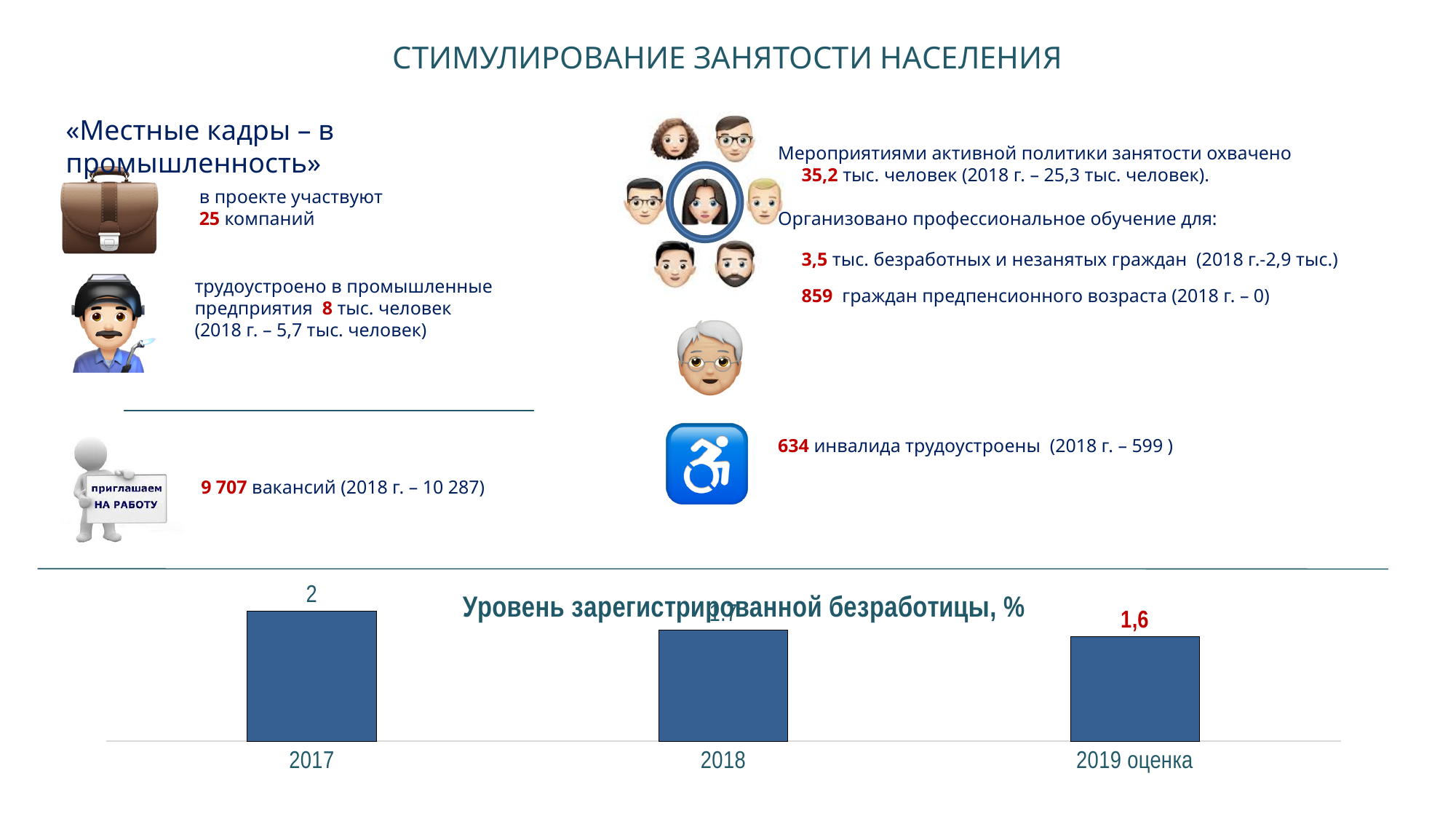
In the chart 'Уровень зарегистрированной безработицы, %', do the values rise or fall from 2017 to 2019 оценка? fall How many bars are plotted in the chart 'Уровень зарегистрированной безработицы, %'? 3 In the chart 'Уровень зарегистрированной безработицы, %', what is the difference between the 2017 value and the 2019 оценка value? 0,4 In the chart 'Уровень зарегистрированной безработицы, %', is the value for 2018 greater or less than 2? less What is the title of the chart at the bottom of the slide? Уровень зарегистрированной безработицы, % In the chart 'Уровень зарегистрированной безработицы, %', which is larger: the value for 2017 or for 2019 оценка? 2017 What type of chart is shown at the bottom of the slide? bar chart In the chart 'Уровень зарегистрированной безработицы, %', which year has the highest value? 2017 In the chart 'Уровень зарегистрированной безработицы, %', what is the value for 2017? 2 What is the label of the last category on the x axis of the chart 'Уровень зарегистрированной безработицы, %'? 2019 оценка In the chart 'Уровень зарегистрированной безработицы, %', what is the value for 2019 оценка? 1,6